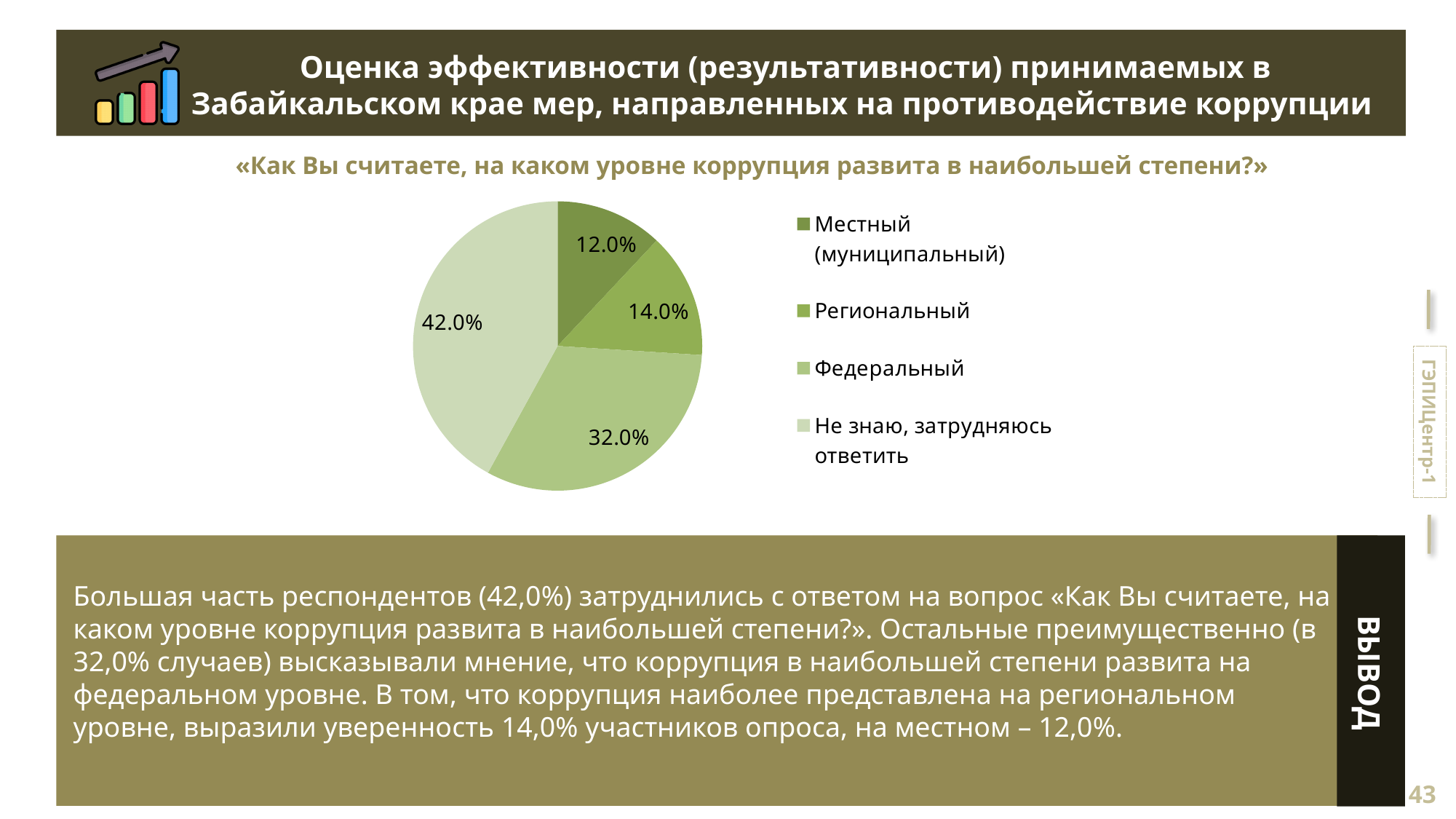
What percentage of respondents chose «Региональный»? 14.0% What share of respondents answered «Не знаю, затрудняюсь ответить»? 42.0% How many categories does the pie chart contain? 4 What percentage of respondents chose «Местный (муниципальный)»? 12.0% What is the difference in percentage points between «Федеральный» and «Региональный»? 18.0 Which is larger: the share for «Региональный» or for «Местный (муниципальный)»? Региональный What percentage of respondents chose «Федеральный»? 32.0% What question is the pie chart about, as shown in its title? «Как Вы считаете, на каком уровне коррупция развита в наибольшей степени?» Which category has the largest slice of the pie? Не знаю, затрудняюсь ответить What type of chart is shown on the slide? Pie chart What is the combined share of «Федеральный» and «Региональный»? 46.0% Which category has the smallest slice of the pie? Местный (муниципальный)